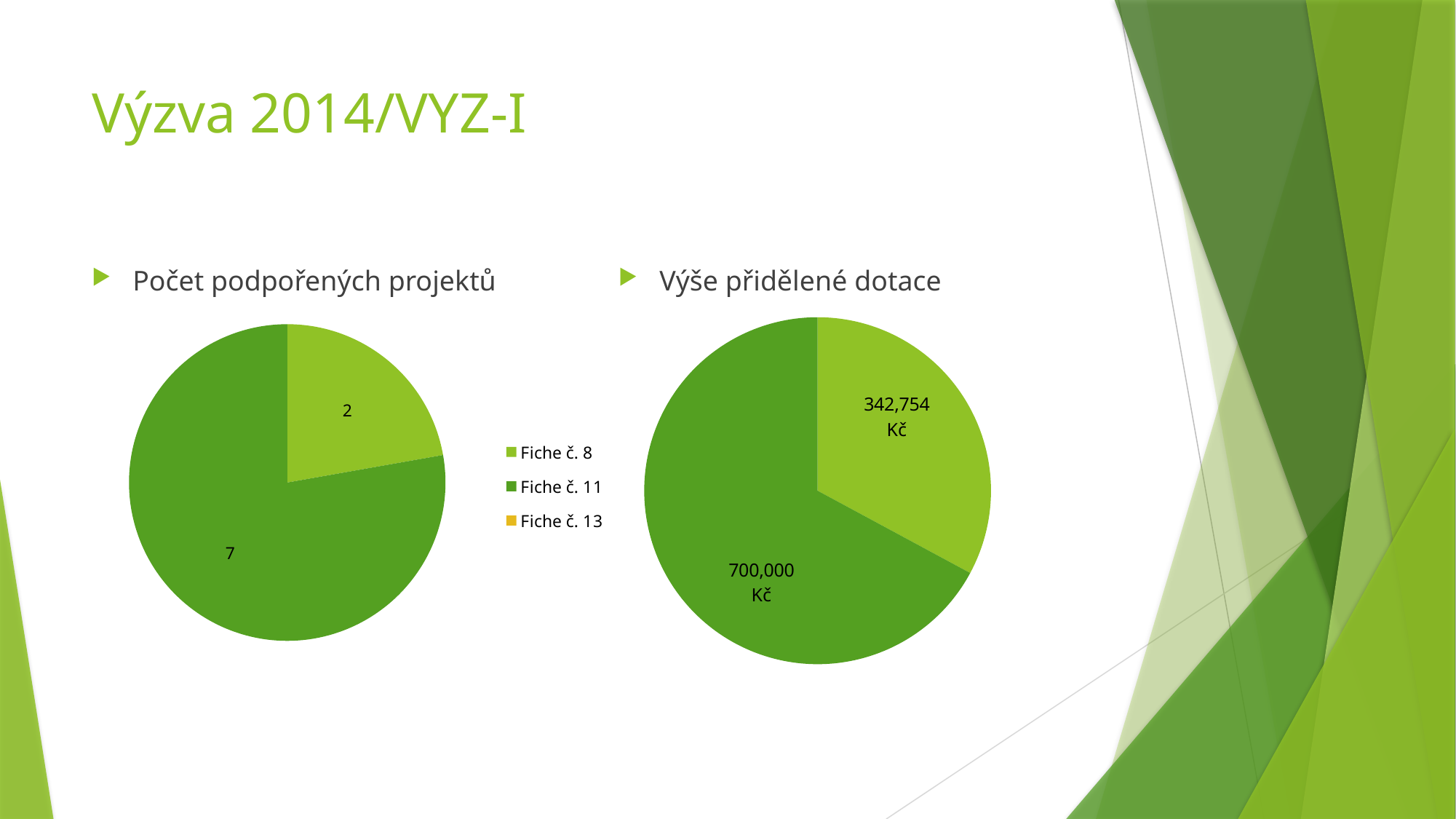
How many entries does the legend list? 3 In the 'Výše přidělené dotace' chart, what is the value for Fiche č. 11? 700,000 Kč In the 'Výše přidělené dotace' chart, what is the difference between the values for Fiche č. 11 and Fiche č. 8? 357,246 Kč In the 'Počet podpořených projektů' chart, what is the difference between the values for Fiche č. 11 and Fiche č. 8? 5 In the 'Výše přidělené dotace' chart, what is the value for Fiche č. 8? 342,754 Kč In the 'Počet podpořených projektů' chart, which category has the smallest visible slice? Fiche č. 8 In the 'Počet podpořených projektů' chart, what is the value for Fiche č. 8? 2 In the 'Počet podpořených projektů' chart, what is the value for Fiche č. 11? 7 What kind of chart is used for 'Počet podpořených projektů'? pie chart What is the total of the values shown in the 'Počet podpořených projektů' chart? 9 In the 'Výše přidělené dotace' chart, which category has the largest slice? Fiche č. 11 In the 'Výše přidělené dotace' chart, is the value for Fiche č. 8 larger or smaller than the value for Fiche č. 11? smaller